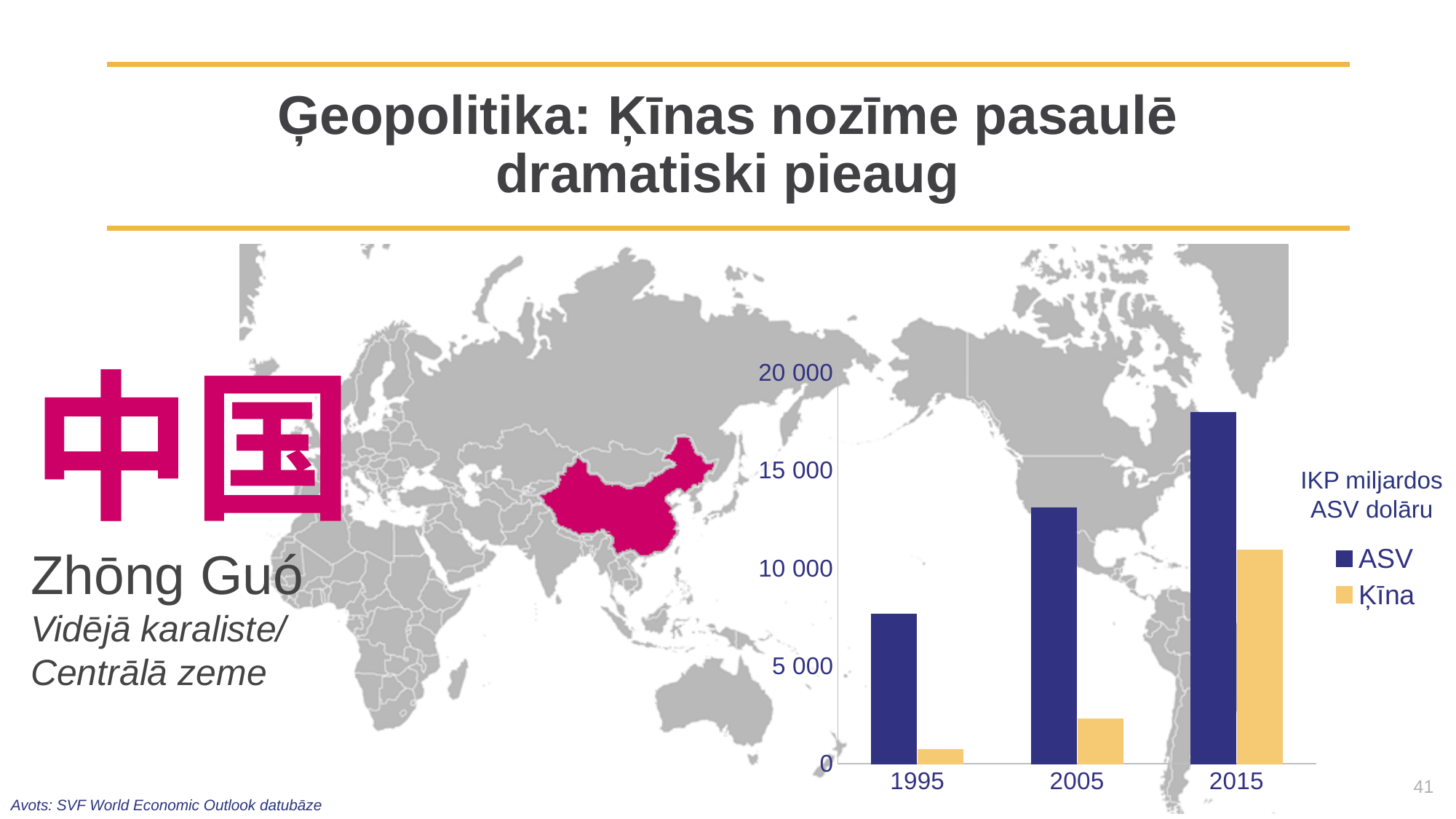
Is the value for ASV in 2015 greater or less than 15 000? greater Do the Ķīna values rise or fall from 1995 to 2015? rise Is the value for ASV in 1995 greater or less than 5 000? greater In which year is the Ķīna bar the lowest? 1995 In 2015, which is larger, the ASV value or the Ķīna value? ASV Which series are listed in the chart legend? ASV and Ķīna Is the value for Ķīna in 2005 greater or less than 5 000? less How many series does the chart legend list? 2 What kind of chart is shown on the slide? bar chart In which year is the ASV bar the highest? 2015 How many years are shown on the x axis of the chart? 3 What is the label shown above the chart legend? IKP miljardos ASV dolāru